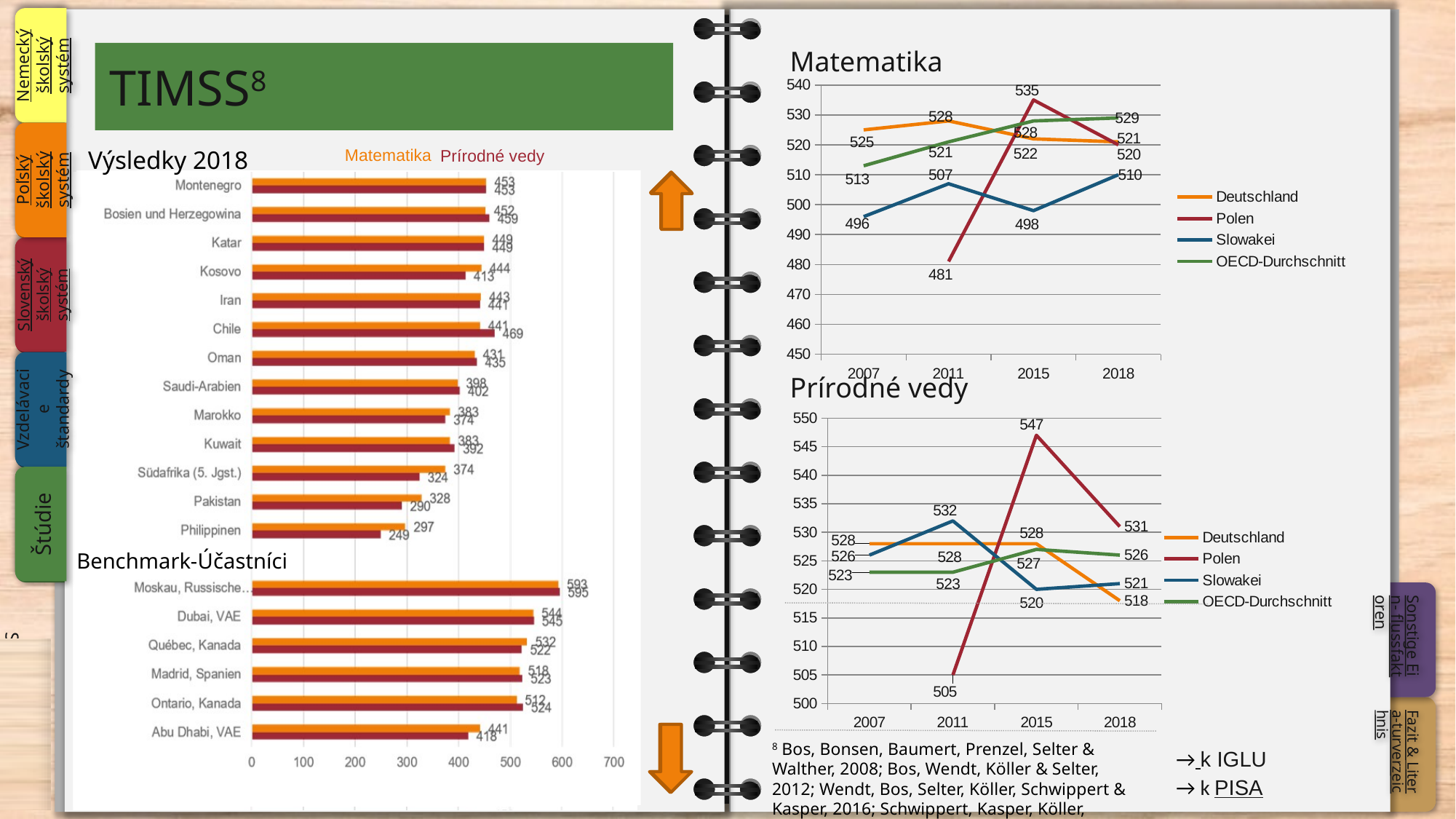
In the Prírodné vedy line chart, what is the value for Polen in 2015? 547 In the Výsledky 2018 bar chart, what is the Matematika value for Moskau? 593 What kind of chart is the Výsledky 2018 chart on the left? bar chart In the Matematika line chart, what is the difference between the OECD-Durchschnitt value in 2018 and in 2007? 16 In the Prírodné vedy line chart, what is the value for Deutschland in 2018? 518 In the Matematika line chart, which series has the lowest value in 2011? Polen In the Matematika line chart, how many series does the legend list? 4 In the Výsledky 2018 bar chart, what is the Prírodné vedy value for Philippinen? 249 In the Matematika line chart, what is the value for Polen in 2015? 535 In the Prírodné vedy line chart, does the Polen line rise or fall from 2015 to 2018? fall In the Matematika line chart, what is the value for Slowakei in 2007? 496 In the Prírodné vedy line chart, which is larger in 2011: Slowakei or OECD-Durchschnitt? Slowakei